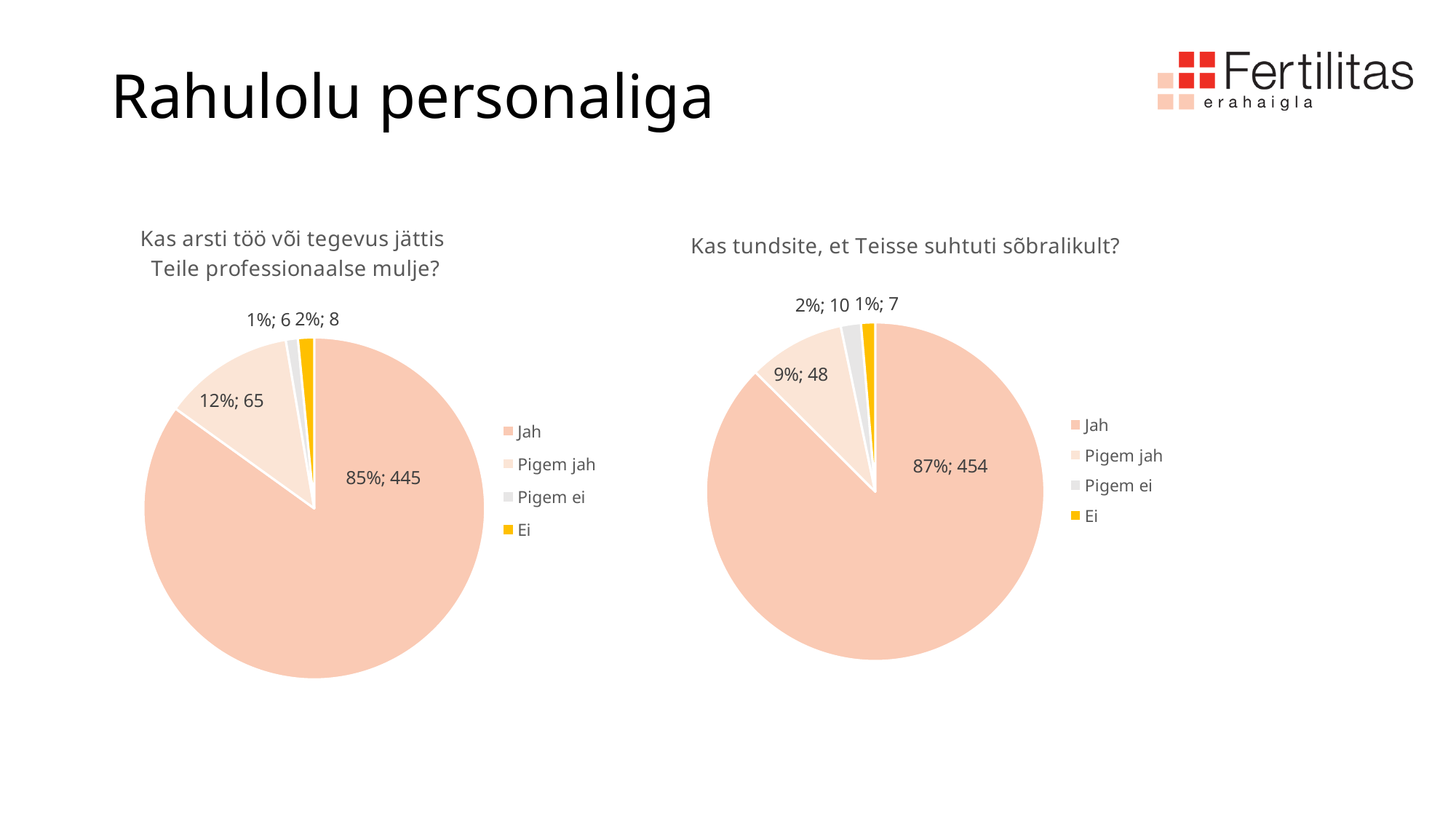
In the right chart (Kas tundsite, et Teisse suhtuti sõbralikult?), what count is shown for Jah? 454 In the left chart (Kas arsti töö või tegevus jättis Teile professionaalse mulje?), what count is shown for Pigem jah? 65 How many categories does the legend of the left chart list? 4 In the left chart (Kas arsti töö või tegevus jättis Teile professionaalse mulje?), what colour is the Ei slice? Yellow In the left chart (Kas arsti töö või tegevus jättis Teile professionaalse mulje?), what is the difference in count between Jah and Pigem jah? 380 In the left chart (Kas arsti töö või tegevus jättis Teile professionaalse mulje?), which category has the smallest slice? Pigem ei In the right chart (Kas tundsite, et Teisse suhtuti sõbralikult?), what share of the pie is Pigem jah? 9% What type of chart is used for the right chart (Kas tundsite, et Teisse suhtuti sõbralikult?)? Pie chart In the right chart (Kas tundsite, et Teisse suhtuti sõbralikult?), which category has the largest slice? Jah In the right chart (Kas tundsite, et Teisse suhtuti sõbralikult?), which is larger, the count for Pigem ei or the count for Ei? Pigem ei In the left chart (Kas arsti töö või tegevus jättis Teile professionaalse mulje?), what share of the pie is the Jah slice? 85% In the right chart (Kas tundsite, et Teisse suhtuti sõbralikult?), what is the difference in count between Pigem ei and Ei? 3